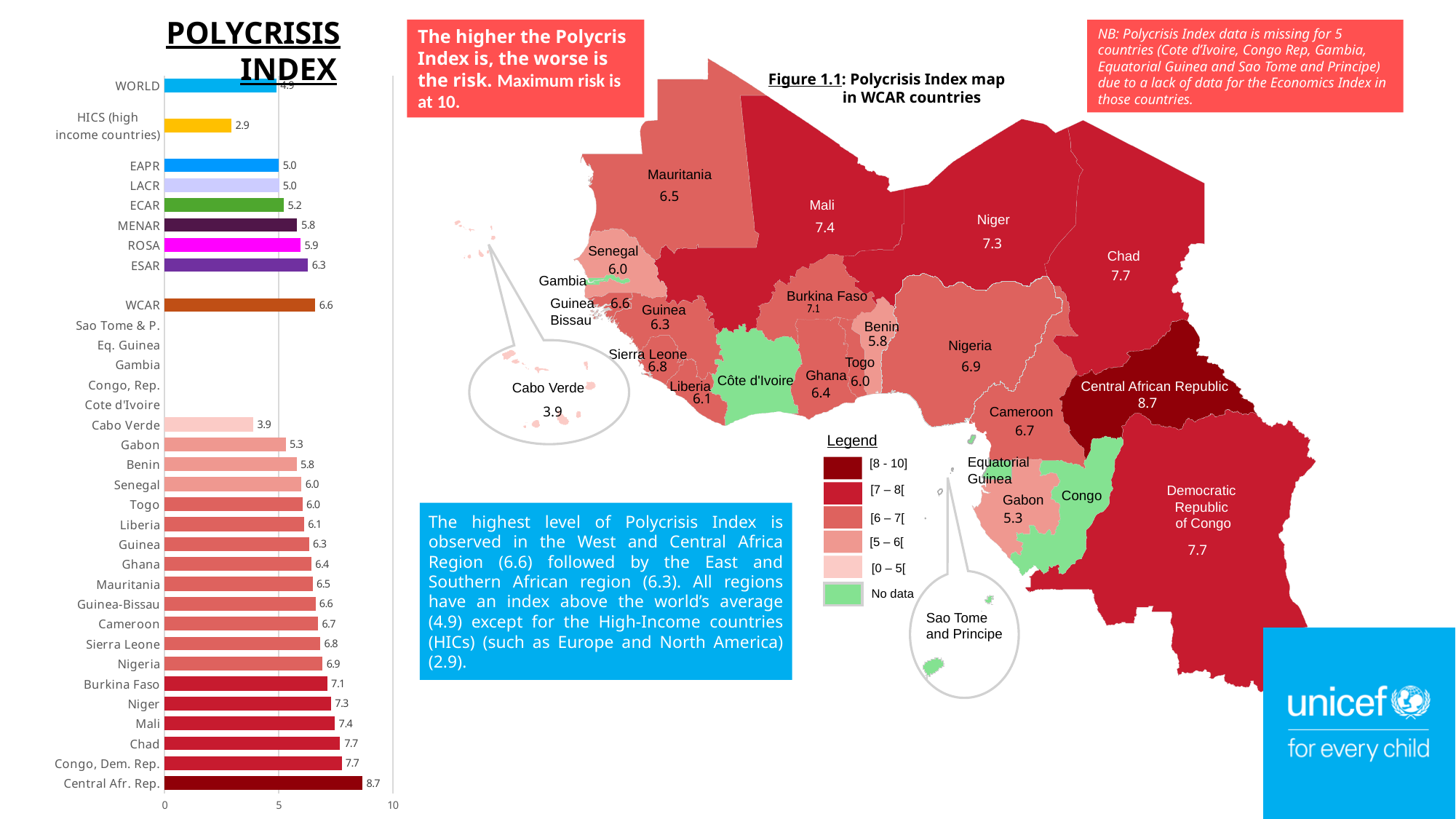
In the POLYCRISIS INDEX bar chart, what is the value for HICS (high income countries)? 2.9 In the POLYCRISIS INDEX bar chart, which category has the lowest plotted value? HICS (high income countries) In the POLYCRISIS INDEX bar chart, which category has the highest value? Central Afr. Rep. In the POLYCRISIS INDEX bar chart, is the value for Gabon greater or less than 5? greater In the POLYCRISIS INDEX bar chart, what is the value for WORLD? 4.9 How many entries does the legend of the Figure 1.1 Polycrisis Index map list? 6 In the POLYCRISIS INDEX bar chart, what is the difference between the values for WCAR and ESAR? 0.3 In the POLYCRISIS INDEX bar chart, what is the difference between the values for Central Afr. Rep. and Cabo Verde? 4.8 In the POLYCRISIS INDEX bar chart, which is larger, the value for Niger or the value for Nigeria? Niger What kind of chart is the POLYCRISIS INDEX chart on the left of the slide? bar chart In the POLYCRISIS INDEX bar chart, what is the value for WCAR? 6.6 On the Figure 1.1 Polycrisis Index map, what is the value shown for Mali? 7.4